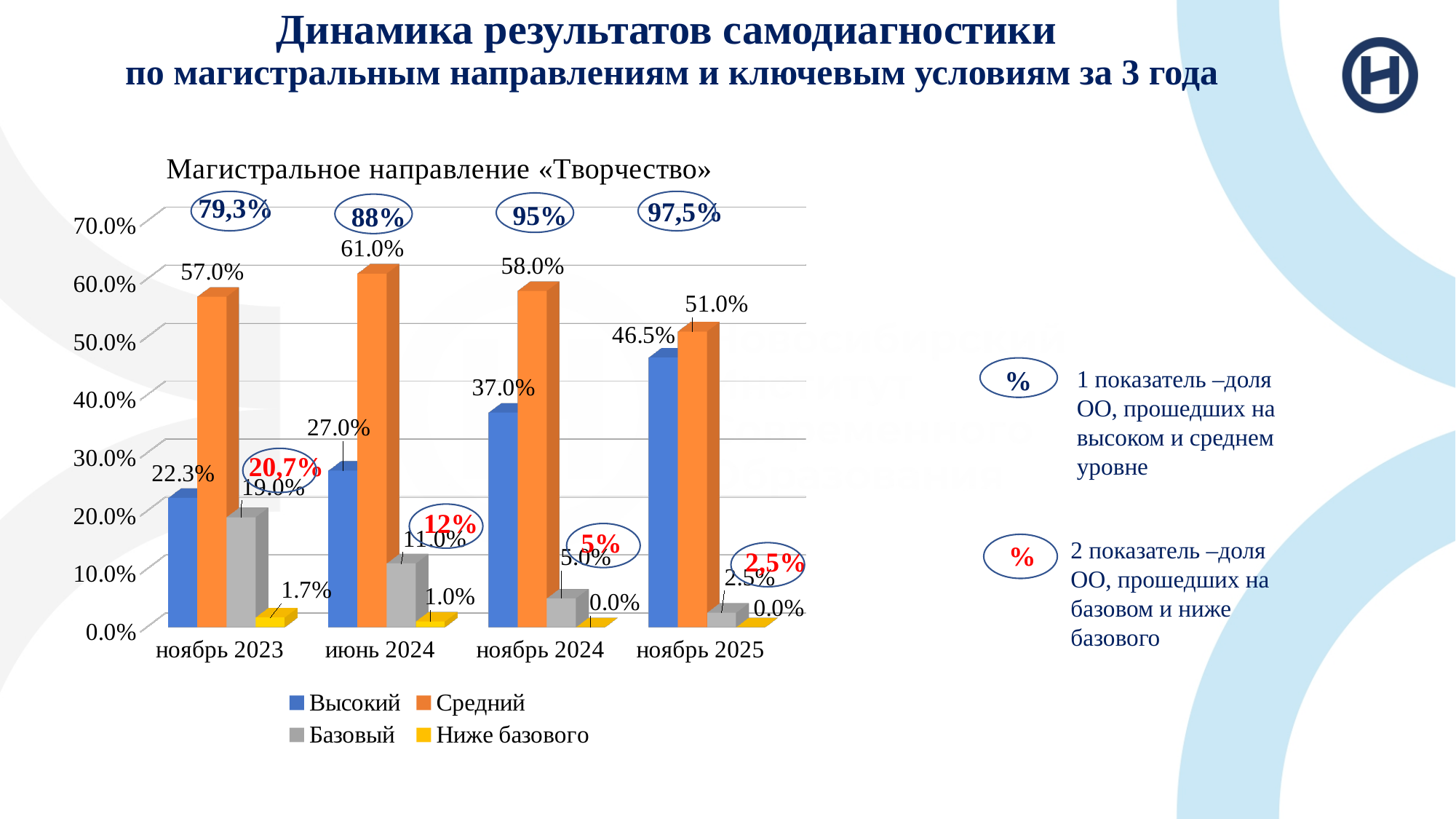
How many periods are shown on the x axis? 4 What is the value for Высокий in ноябрь 2025? 46.5% What is the value for Средний in июнь 2024? 61.0% Which is larger in ноябрь 2025: Высокий or Средний? Средний What is the value for Базовый in ноябрь 2023? 19.0% What is the difference between the Средний and Высокий values in ноябрь 2024? 21.0% What is the value for Ниже базового in ноябрь 2023? 1.7% Does the Высокий series rise or fall from ноябрь 2023 to ноябрь 2025? rise What kind of chart is shown? bar chart In which period is the Базовый series lowest? ноябрь 2025 How many series does the legend list? 4 In which period is the Высокий series highest? ноябрь 2025